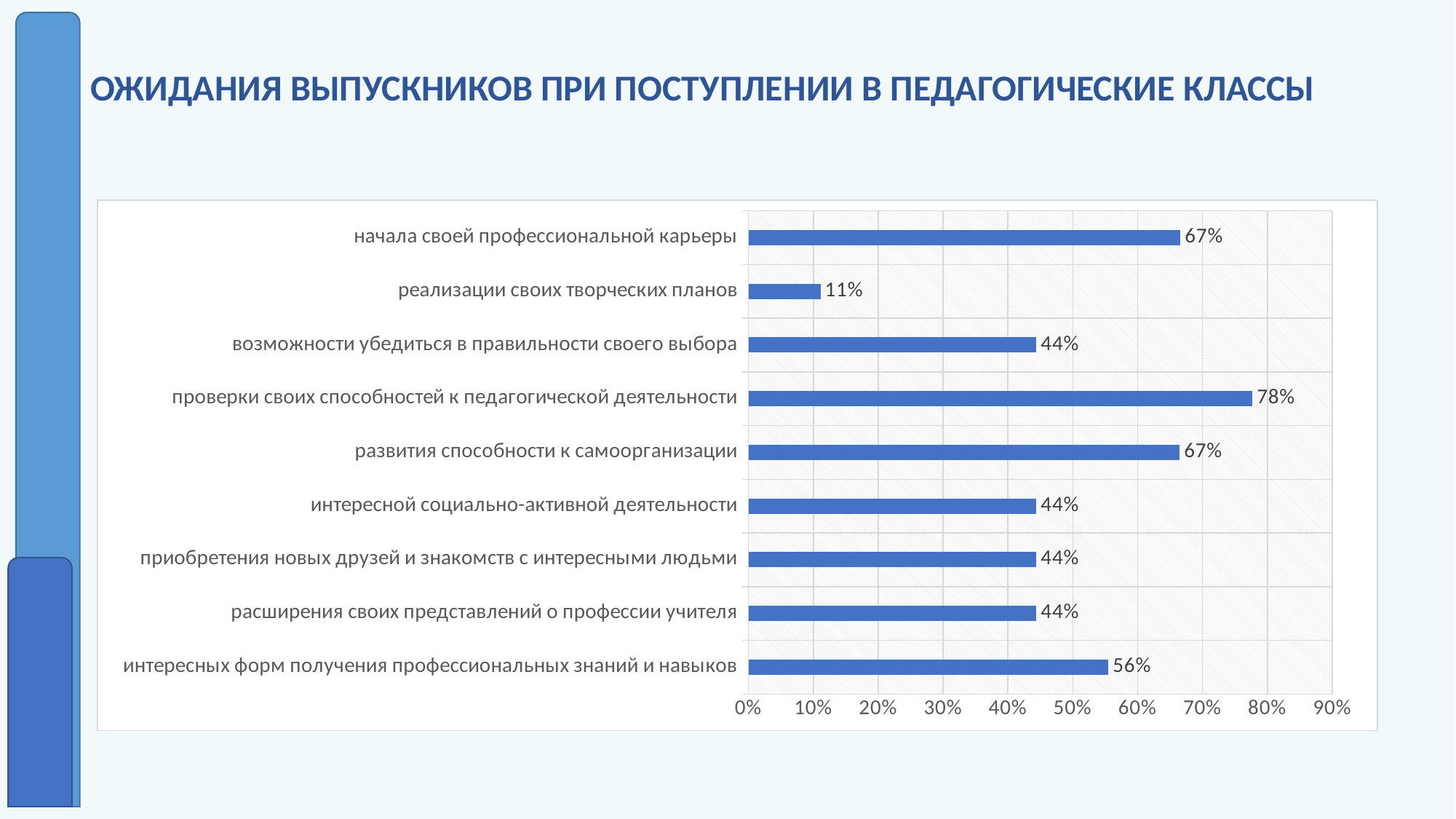
What is the difference between the values for «проверки своих способностей к педагогической деятельности» and «реализации своих творческих планов»? 67% What is the difference between the values for «начала своей профессиональной карьеры» and «интересных форм получения профессиональных знаний и навыков»? 11% How many categories are shown in the chart? 9 What is the value for «проверки своих способностей к педагогической деятельности»? 78% What kind of chart is shown on the slide? bar chart Which category has the lowest value? реализации своих творческих планов Which category has the highest value? проверки своих способностей к педагогической деятельности What is the title of the slide? ОЖИДАНИЯ ВЫПУСКНИКОВ ПРИ ПОСТУПЛЕНИИ В ПЕДАГОГИЧЕСКИЕ КЛАССЫ What is the value for «развития способности к самоорганизации»? 67% What is the value for «реализации своих творческих планов»? 11% Which is larger: the value for «интересных форм получения профессиональных знаний и навыков» or for «расширения своих представлений о профессии учителя»? интересных форм получения профессиональных знаний и навыков What is the value for «интересных форм получения профессиональных знаний и навыков»? 56%